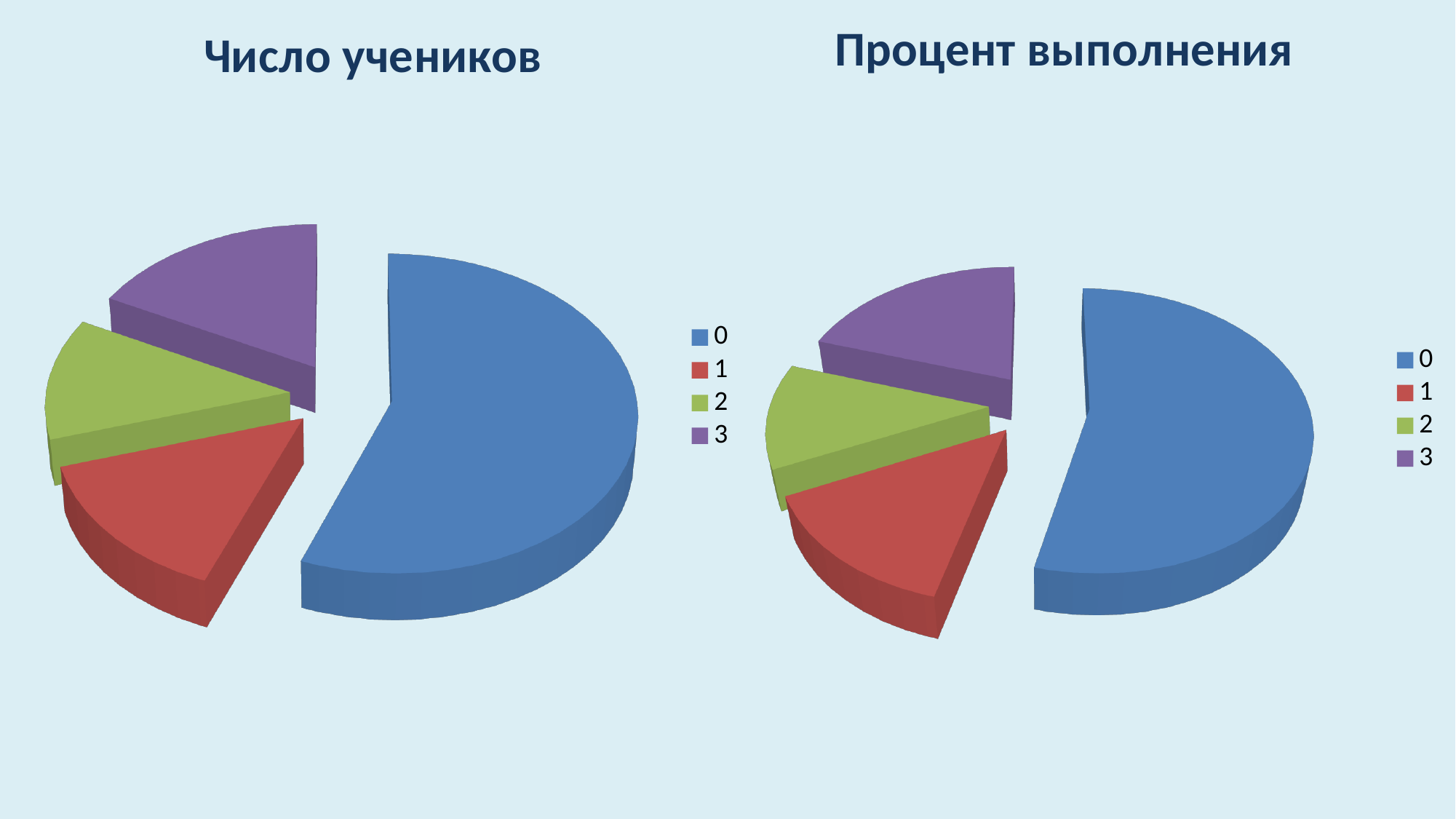
What is the title of the chart on the left side of the slide? Число учеников In the chart titled "Процент выполнения", what colour is the slice for category 3? purple In the chart titled "Процент выполнения", which slice is larger, category 0 or category 2? 0 What kind of chart is the chart titled "Процент выполнения"? pie chart In the chart titled "Процент выполнения", which category has the largest slice? 0 In the chart titled "Число учеников", how many slices does the pie have? 4 In the chart titled "Процент выполнения", how many entries does the legend list? 4 In the chart titled "Число учеников", which category has the largest slice? 0 In the chart titled "Число учеников", which slice is larger, category 0 or category 1? 0 What kind of chart is the chart titled "Число учеников"? pie chart